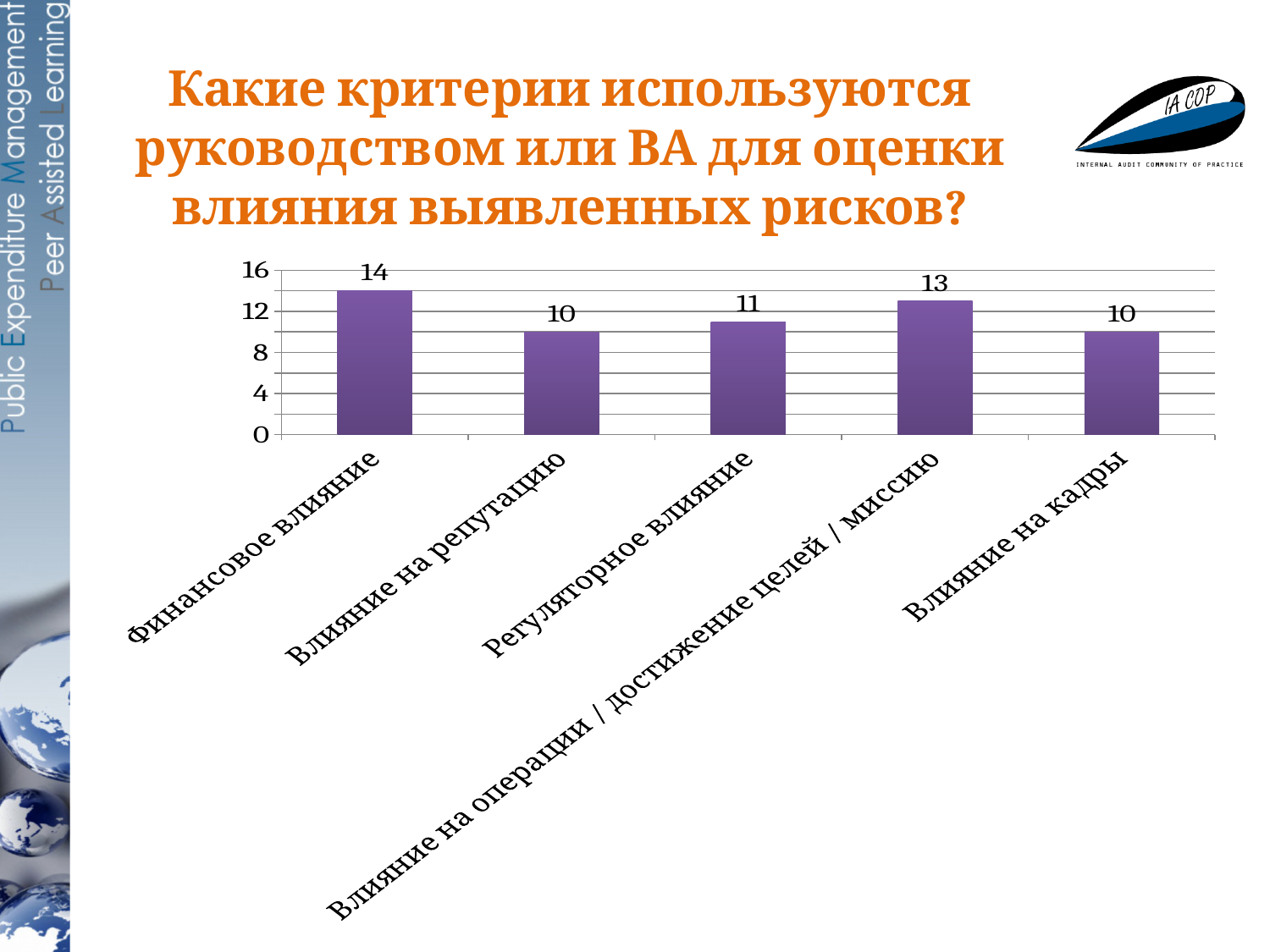
What is the value for Регуляторное влияние? 11 How many categories are shown on the x axis? 5 What is the value for Влияние на операции / достижение целей / миссию? 13 What is the value for Влияние на кадры? 10 Is the value for Финансовое влияние greater or less than 12? greater What is the difference between the values for Финансовое влияние and Влияние на репутацию? 4 Which category has the highest value? Финансовое влияние What is the maximum value shown on the vertical axis? 16 What is the difference between the values for Влияние на операции / достижение целей / миссию and Регуляторное влияние? 2 What kind of chart is shown on the slide? bar chart Which is larger, the value for Регуляторное влияние or the value for Влияние на кадры? Регуляторное влияние What is the value for Финансовое влияние? 14